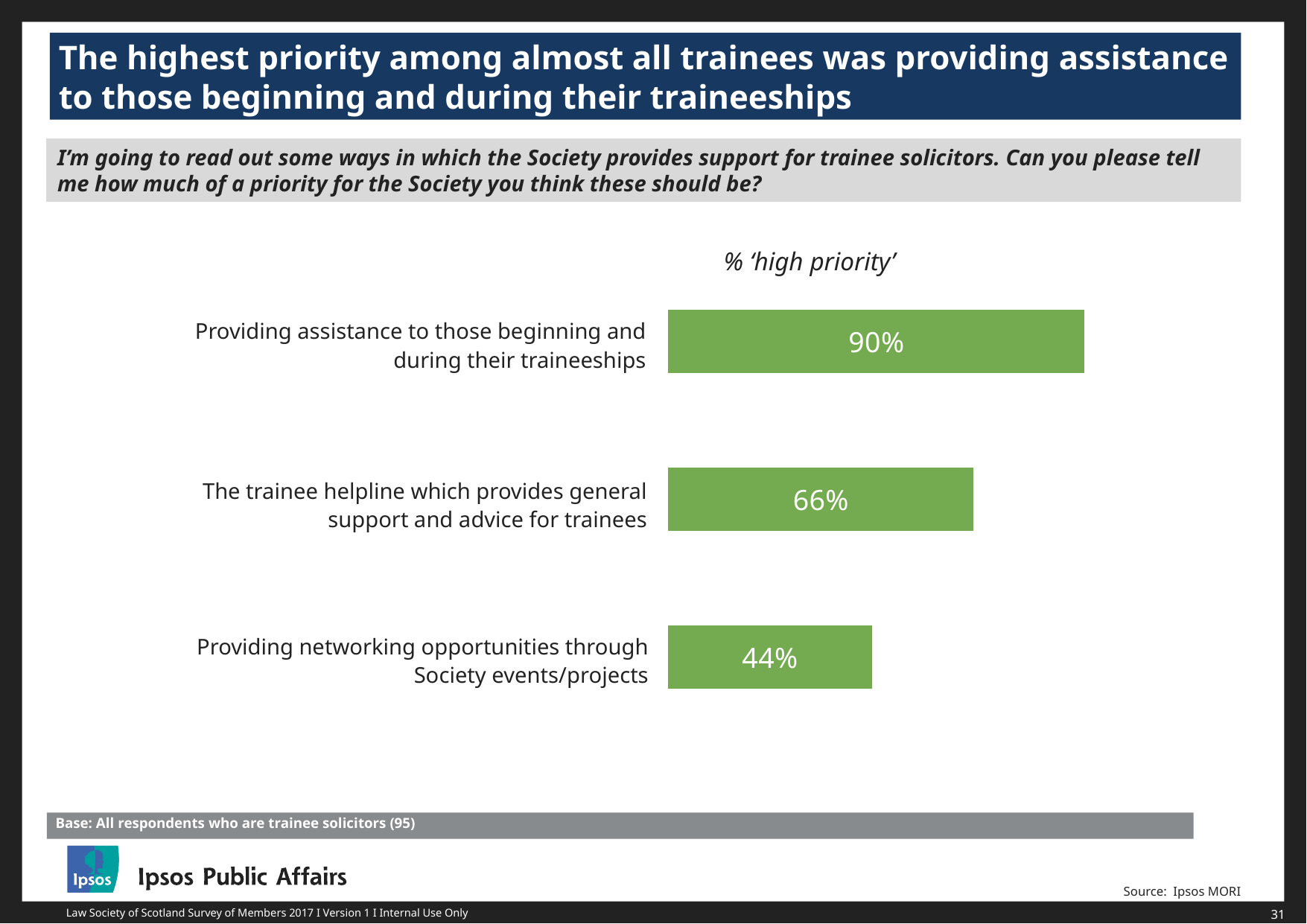
What percentage of trainees rated the trainee helpline which provides general support and advice for trainees as a high priority? 66% What is the base of respondents for the chart? All respondents who are trainee solicitors (95) What measure do the bars in the chart represent, according to the label above them? % 'high priority' What type of chart is shown on the slide? Bar chart Which received a higher 'high priority' share: the trainee helpline or providing networking opportunities through Society events/projects? The trainee helpline which provides general support and advice for trainees What is the difference in percentage points between the 'high priority' share for the trainee helpline and for providing networking opportunities through Society events/projects? 22 percentage points What percentage of trainees rated providing assistance to those beginning and during their traineeships as a high priority? 90% What percentage of trainees rated providing networking opportunities through Society events/projects as a high priority? 44% Which support area has the highest share of trainees rating it a high priority? Providing assistance to those beginning and during their traineeships What is the difference in percentage points between the 'high priority' share for providing assistance to those beginning and during their traineeships and for the trainee helpline? 24 percentage points How many support areas are shown in the chart? 3 Which support area has the lowest share of trainees rating it a high priority? Providing networking opportunities through Society events/projects